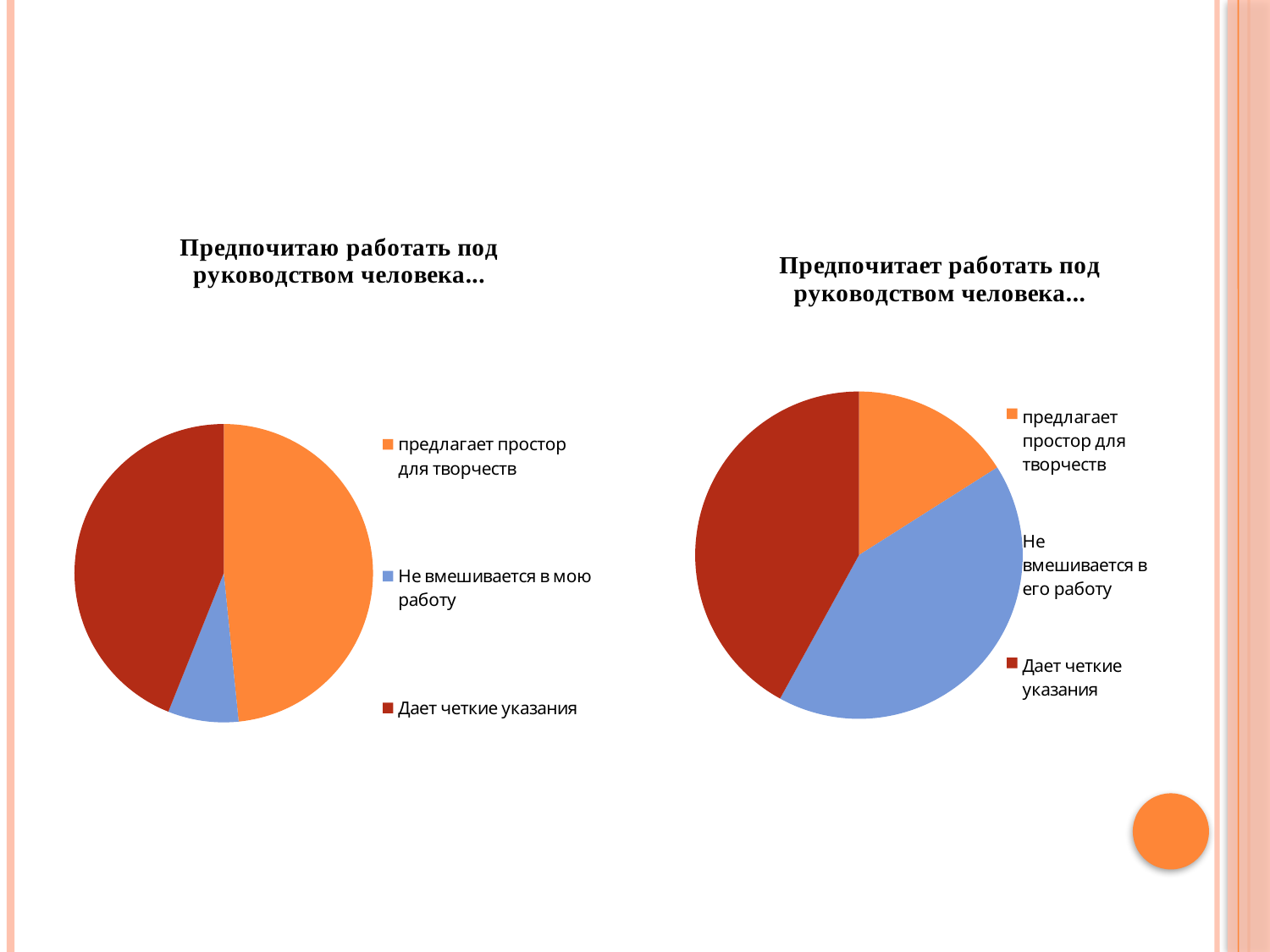
In the left chart, which category has the smallest slice? Не вмешивается в мою работу In the right chart, which category has the smallest slice? предлагает простор для творчеств What kind of chart is the right chart titled "Предпочитает работать под руководством человека..."? pie chart What is the title of the left chart? Предпочитаю работать под руководством человека... In the left chart, how many slices does the pie have? 3 In the left chart, which is larger: the slice for "предлагает простор для творчеств" or the slice for "Не вмешивается в мою работу"? предлагает простор для творчеств In the right chart, how many categories does the legend list? 3 Is the slice for "предлагает простор для творчеств" larger in the left chart or in the right chart? the left chart In the right chart, which is larger: the slice for "Дает четкие указания" or the slice for "предлагает простор для творчеств"? Дает четкие указания In the right chart, what colour is the slice for "Дает четкие указания"? dark red What kind of chart is the left chart titled "Предпочитаю работать под руководством человека..."? pie chart